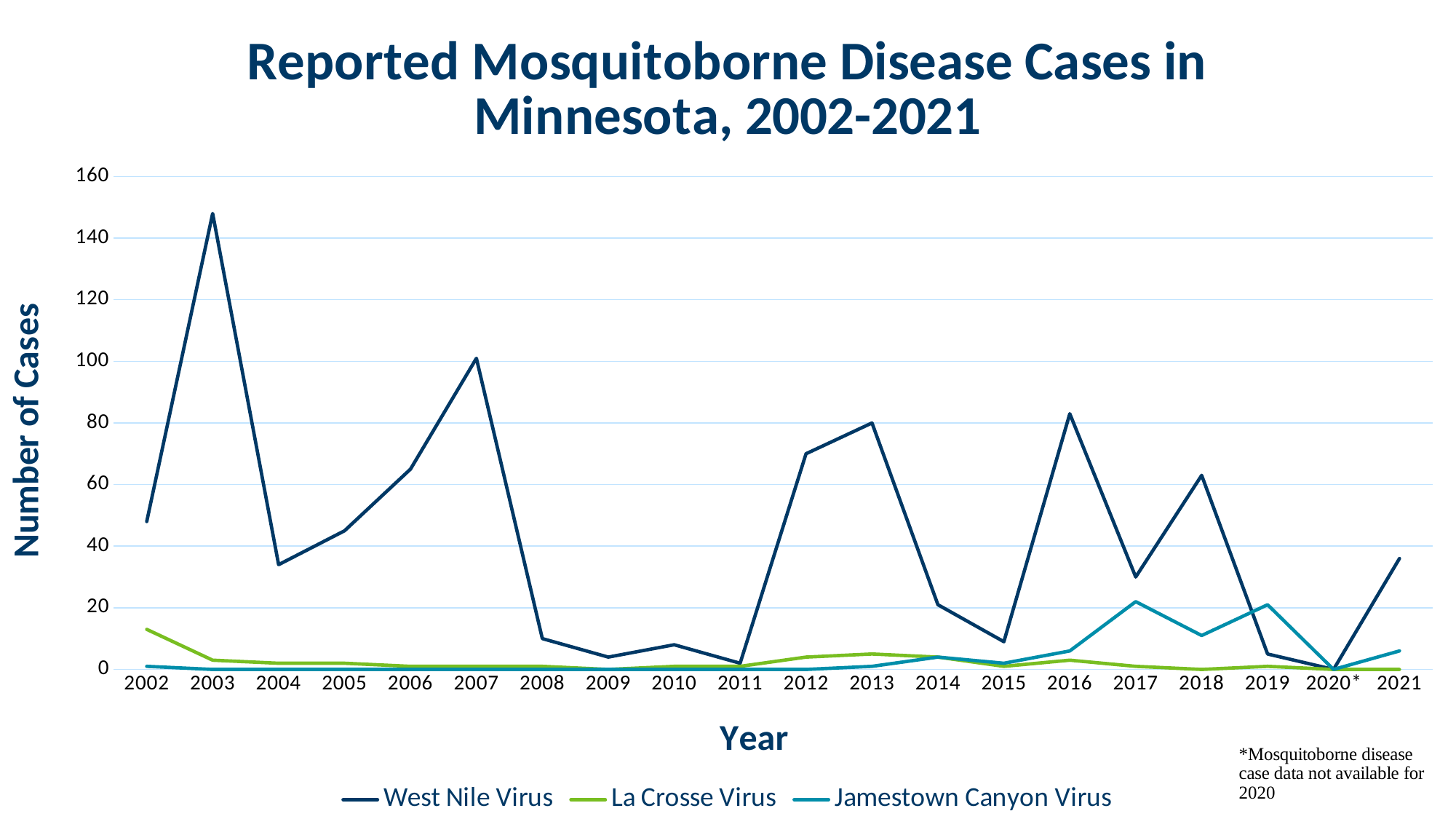
What kind of chart is shown on the slide? Line chart Is the number of West Nile Virus cases in 2003 greater or less than 140? greater According to the footnote, for which year is mosquitoborne disease case data not available? 2020 Did West Nile Virus cases rise or fall from 2004 to 2007? Rise Which year had more West Nile Virus cases, 2003 or 2007? 2003 Which year had more Jamestown Canyon Virus cases, 2017 or 2018? 2017 How many years are shown along the x axis? 20 Is the number of La Crosse Virus cases in 2002 greater or less than 20? less In which year did West Nile Virus have the highest number of reported cases? 2003 Is the number of West Nile Virus cases in 2008 greater or less than 20? less How many series does the legend list? 3